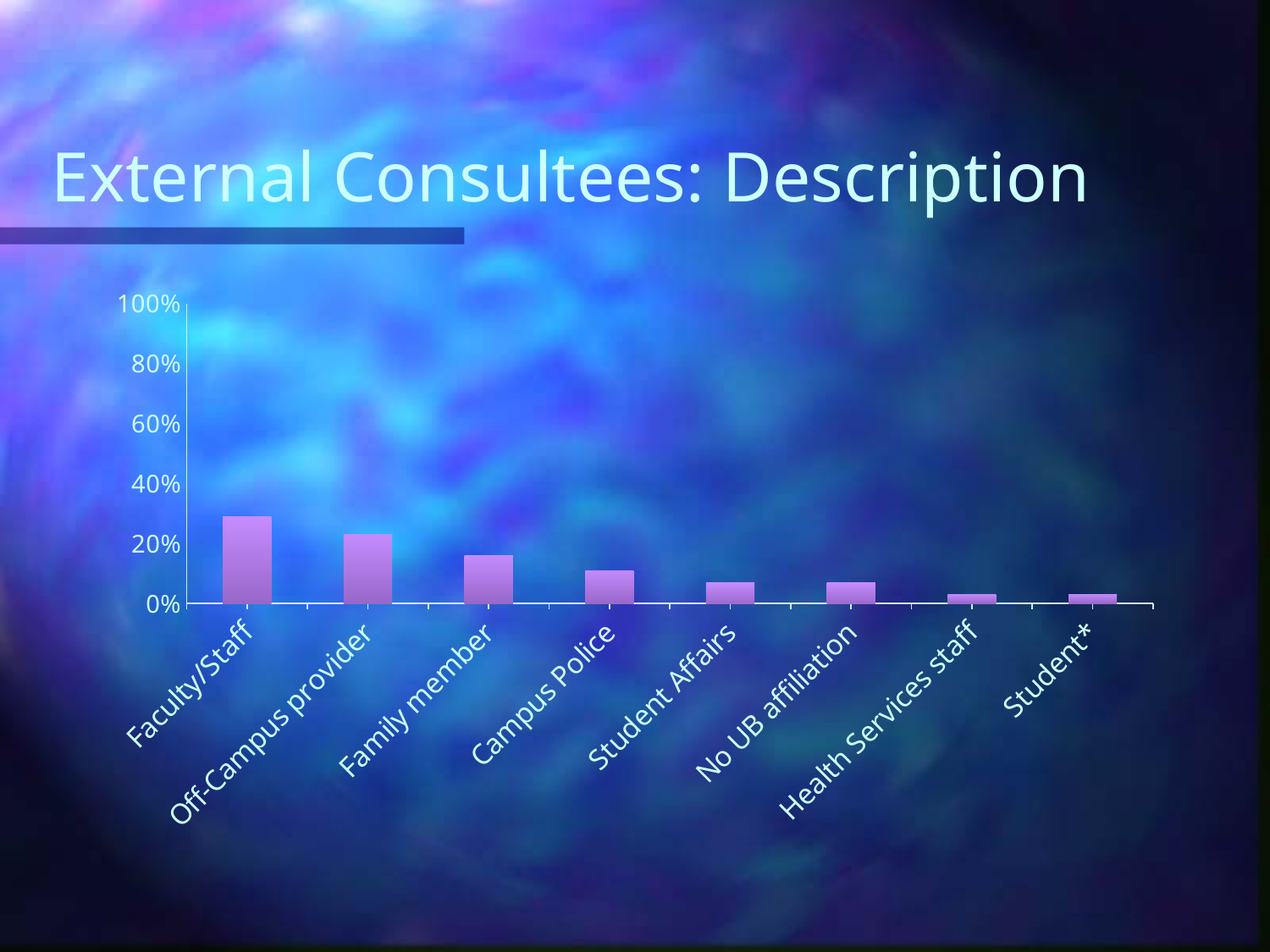
Is the value for Faculty/Staff greater or less than 20%? greater Which category has the highest value in the chart? Faculty/Staff Is the value for Family member greater or less than 20%? less Which is larger, the value for Campus Police or the value for Health Services staff? Campus Police How many categories are shown on the x axis of the chart? 8 Is the value for Faculty/Staff greater or less than 40%? less Which is larger, the value for Off-Campus provider or the value for Family member? Off-Campus provider Do the values generally rise or fall from left to right along the x axis? fall What kind of chart is shown on the slide? bar chart What is the title of the slide containing the chart? External Consultees: Description